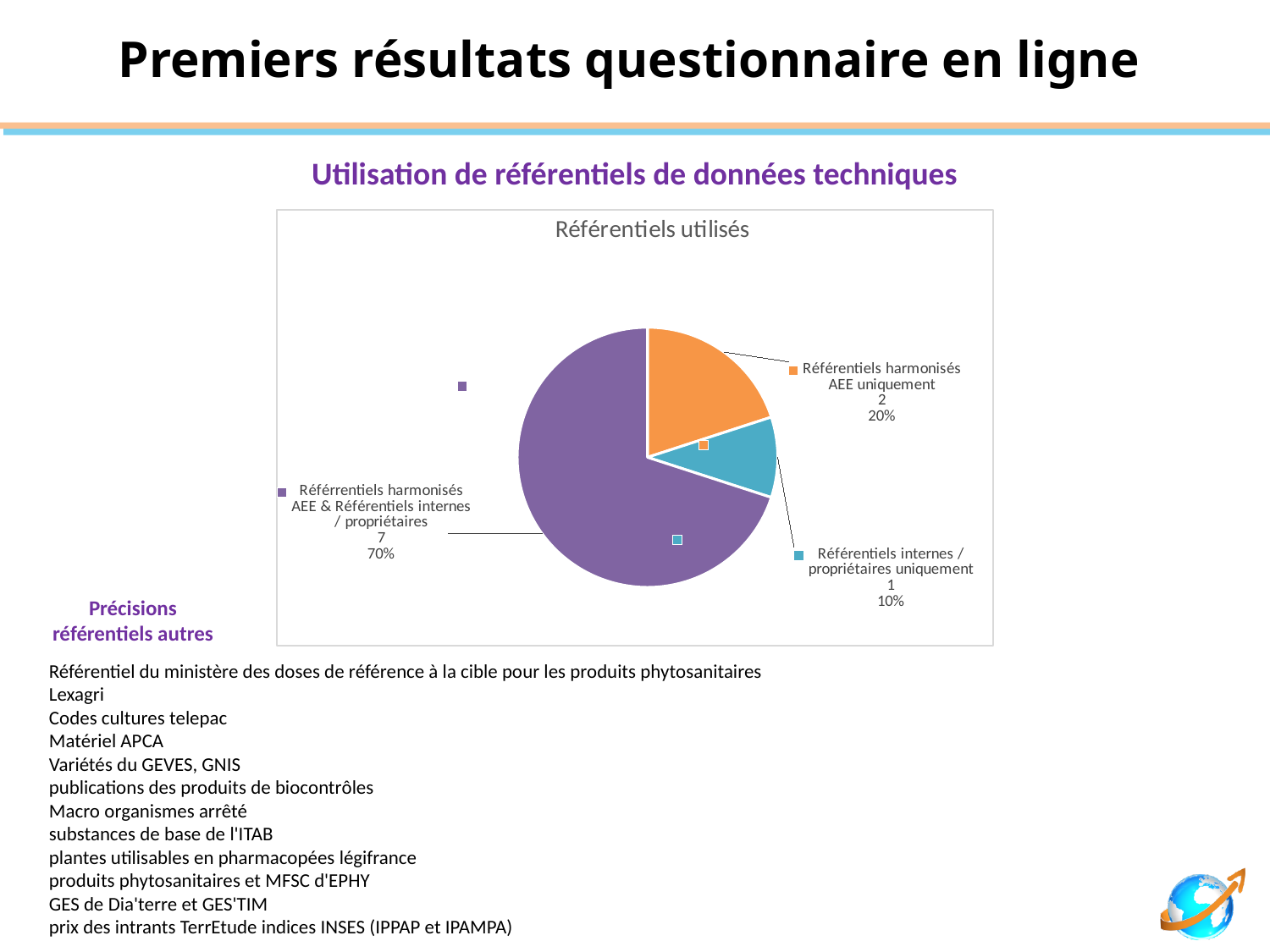
Which category has the smallest slice of the pie? Référentiels internes / propriétaires uniquement What is the count for 'Référentiels harmonisés AEE uniquement'? 2 What is the count for 'Référentiels internes / propriétaires uniquement'? 1 What share of the pie does 'Référentiels harmonisés AEE & Référentiels internes / propriétaires' represent? 70% What share of the pie does 'Référentiels internes / propriétaires uniquement' represent? 10% Which category has the largest slice of the pie? Référentiels harmonisés AEE & Référentiels internes / propriétaires What is the title of the chart? Référentiels utilisés What type of chart is shown on the slide? Pie chart What is the count for 'Référentiels harmonisés AEE & Référentiels internes / propriétaires'? 7 How many slices does the pie chart have? 3 What is the difference in count between 'Référentiels harmonisés AEE & Référentiels internes / propriétaires' and 'Référentiels harmonisés AEE uniquement'? 5 What percentage of the pie is 'Référentiels harmonisés AEE uniquement'? 20%